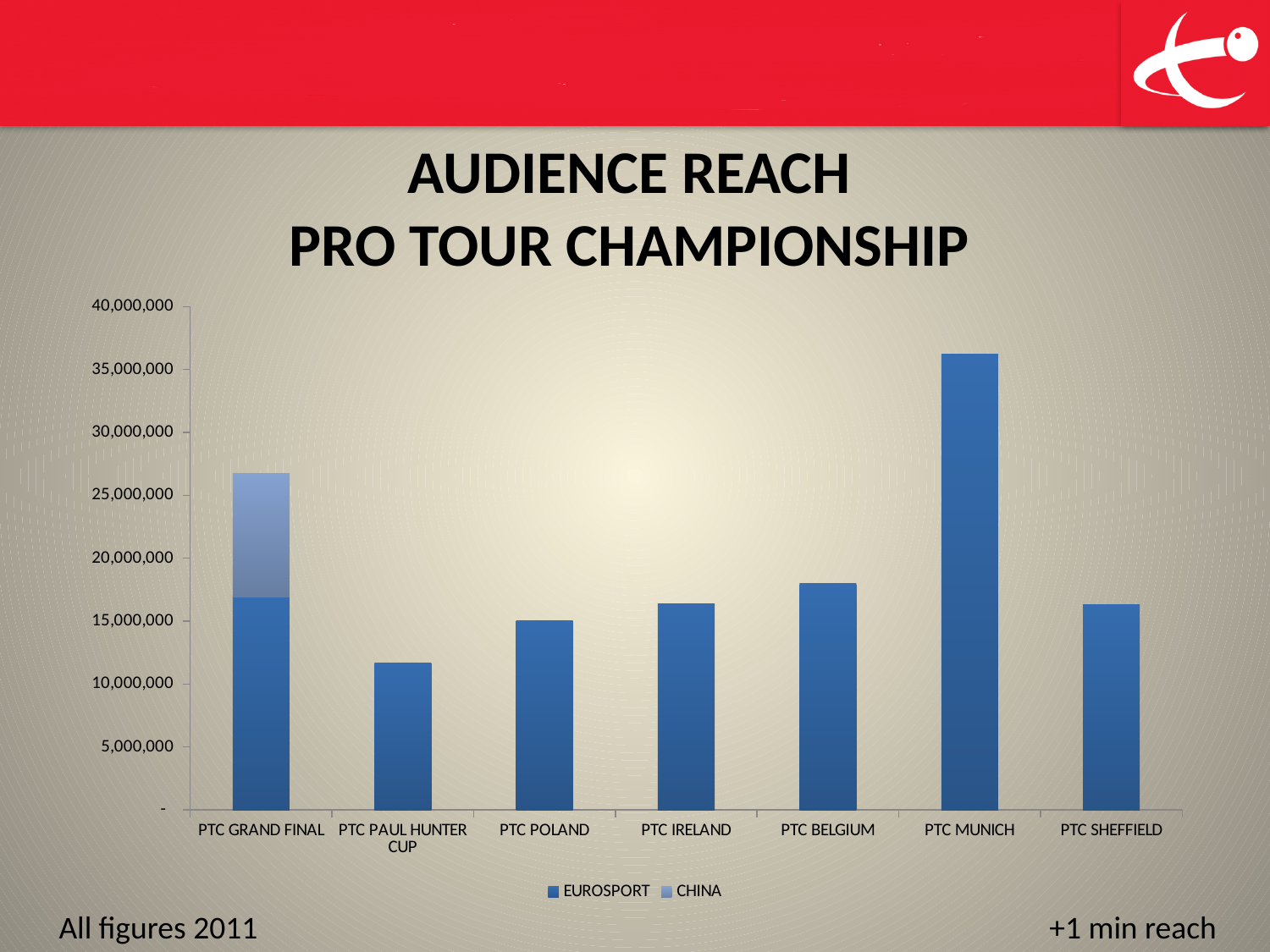
Is the value for PTC PAUL HUNTER CUP greater or less than 15,000,000? less Which event has the highest audience reach in the chart? PTC MUNICH Is the value for PTC BELGIUM greater or less than 15,000,000? greater Which has the larger audience reach, PTC BELGIUM or PTC POLAND? PTC BELGIUM Which has the larger audience reach, PTC MUNICH or PTC BELGIUM? PTC MUNICH Which event is the only one with a CHINA segment in its bar? PTC GRAND FINAL Is the value for PTC MUNICH greater or less than 35,000,000? greater What are the two series named in the chart's legend? EUROSPORT and CHINA Which event has the lowest audience reach in the chart? PTC PAUL HUNTER CUP What kind of chart is shown on the slide? bar chart How many series does the chart's legend list? 2 How many categories (events) are shown on the x axis of the chart? 7